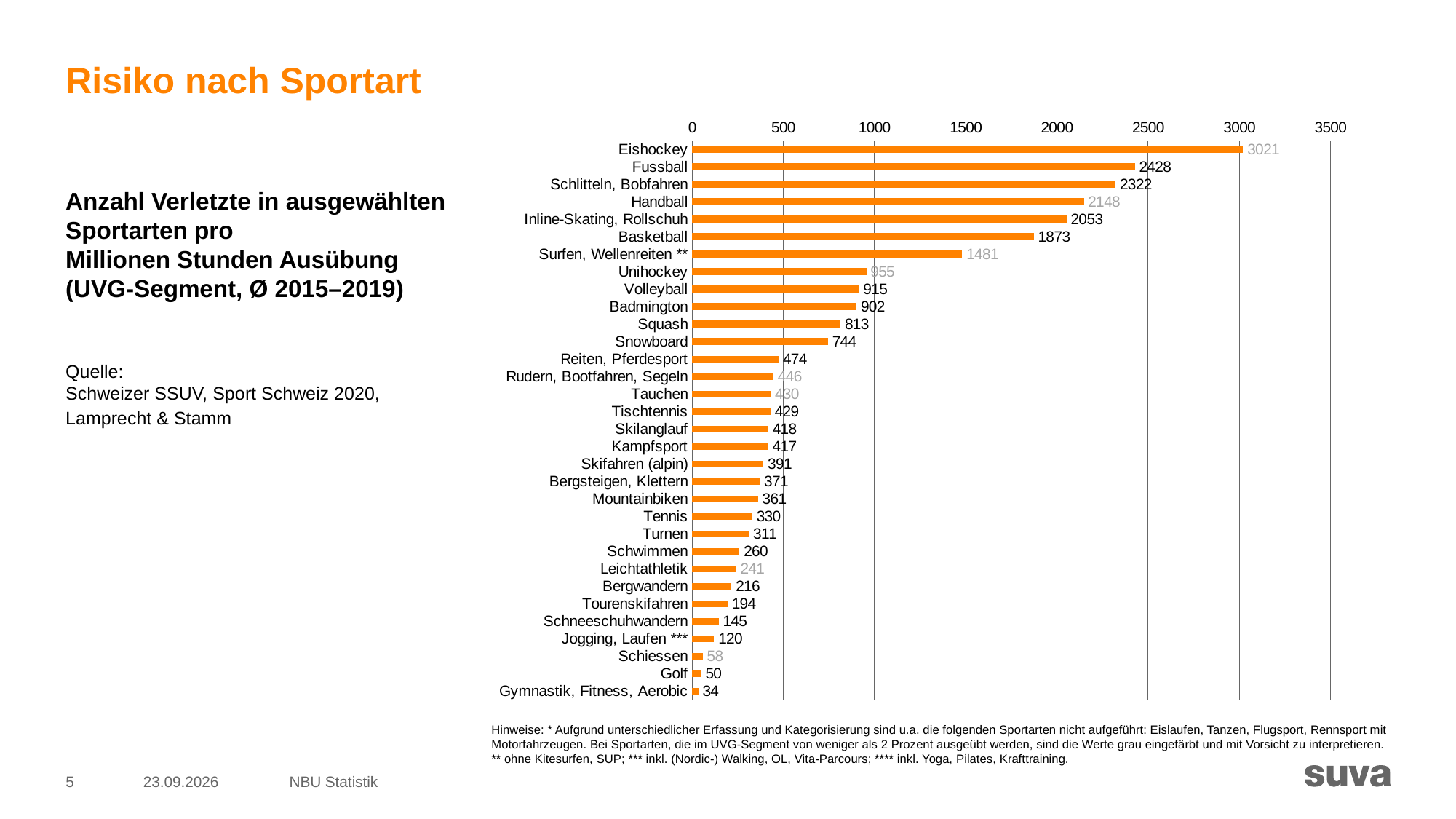
What is the value for Eishockey? 3021 Which has a larger value, Tennis or Turnen? Tennis What is the value for Golf? 50 What is the value for Snowboard? 744 Is the value for Unihockey greater or less than 1000? less What is the value for Basketball? 1873 What is the value for Jogging, Laufen ***? 120 How many sports are shown in the chart? 32 Which sport has the lowest value? Gymnastik, Fitness, Aerobic Which sport has the highest value? Eishockey What is the difference between the values for Fussball and Handball? 280 What kind of chart is shown on the slide? bar chart